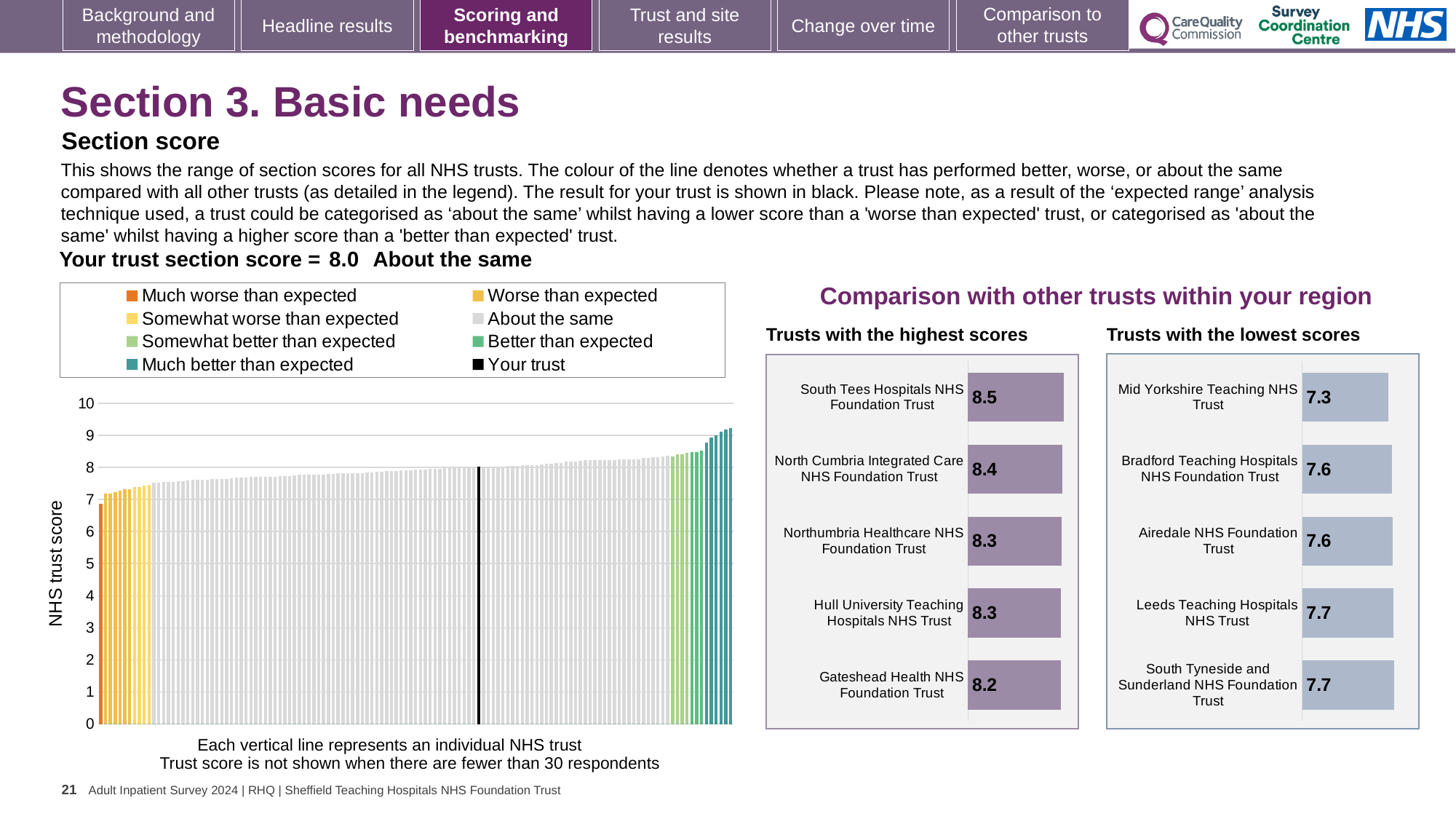
In the 'Trusts with the lowest scores' chart, what is the score for Mid Yorkshire Teaching NHS Trust? 7.3 In the 'Trusts with the lowest scores' chart, what is the score for Leeds Teaching Hospitals NHS Trust? 7.7 In the main 'NHS trust score' chart on the left, what is the section score for your trust? 8.0 In the 'Trusts with the lowest scores' chart, which has the larger score: Bradford Teaching Hospitals NHS Foundation Trust or Leeds Teaching Hospitals NHS Trust? Leeds Teaching Hospitals NHS Trust In the 'Trusts with the highest scores' chart, what is the score for South Tees Hospitals NHS Foundation Trust? 8.5 In the 'Trusts with the lowest scores' chart, which trust has the lowest score? Mid Yorkshire Teaching NHS Trust In the main 'NHS trust score' chart on the left, is the value of the highest bar greater or less than 9? greater In the 'Trusts with the highest scores' chart, what is the score for Gateshead Health NHS Foundation Trust? 8.2 How many trusts are shown in the 'Trusts with the lowest scores' chart? 5 In the 'Trusts with the highest scores' chart, which trust has the highest score? South Tees Hospitals NHS Foundation Trust In the 'Trusts with the highest scores' chart, what is the difference between the scores of South Tees Hospitals NHS Foundation Trust and Gateshead Health NHS Foundation Trust? 0.3 How many entries does the legend of the main 'NHS trust score' chart on the left list? 8